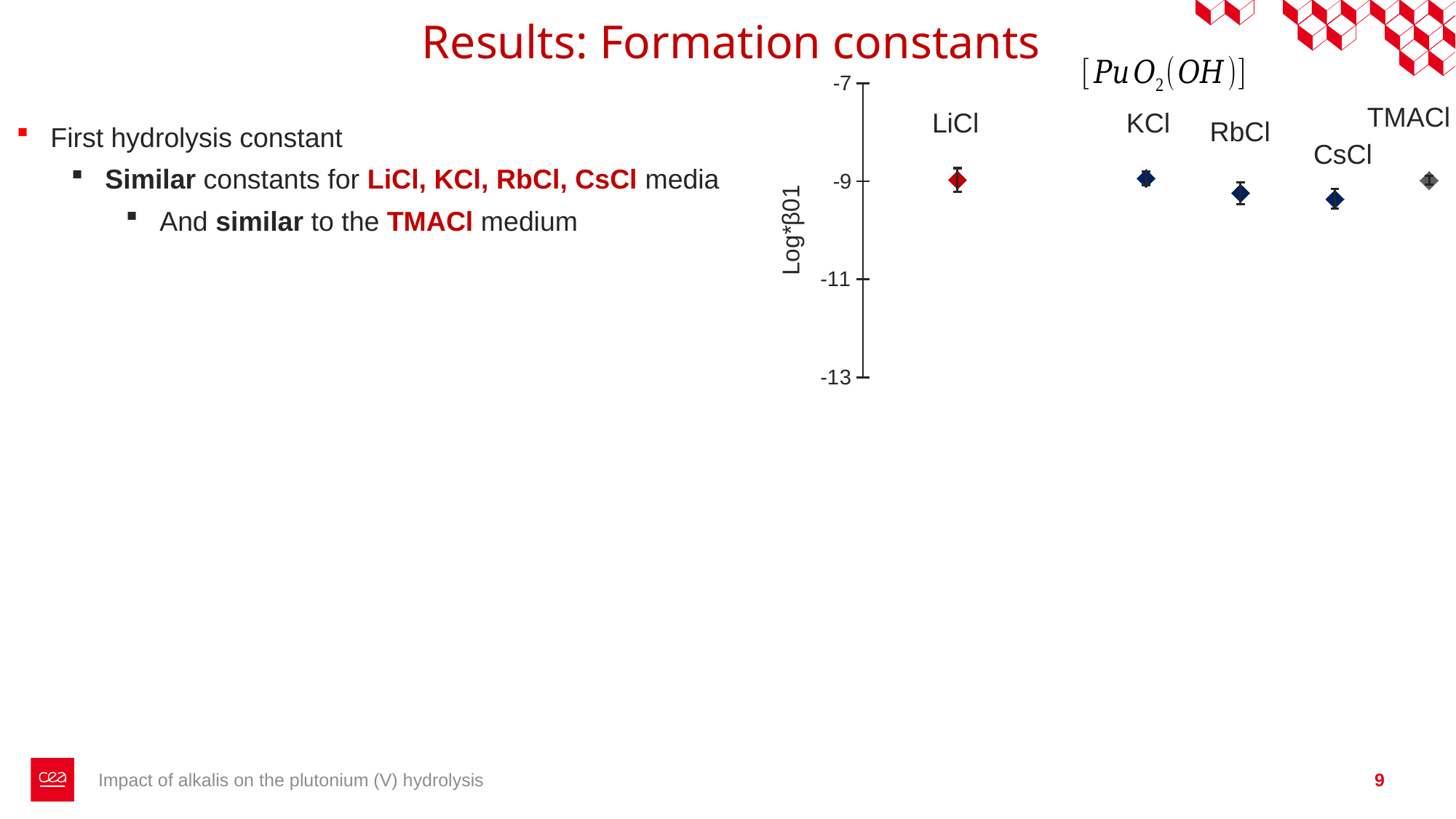
Which has the higher Log*β01 value, LiCl or CsCl? LiCl Which has the higher Log*β01 value, KCl or RbCl? KCl What kind of chart is shown on the slide? Scatter plot What is the lowest value shown on the y axis of the chart? -13 Is the value for CsCl greater or less than -11? greater Is the value for TMACl greater or less than -11? greater How many media (categories) are plotted on the chart? 5 Which species is named in the title above the chart? [PuO2(OH)] What is the label of the y axis of the chart? Log*β01 Is the value for RbCl greater or less than -9? less